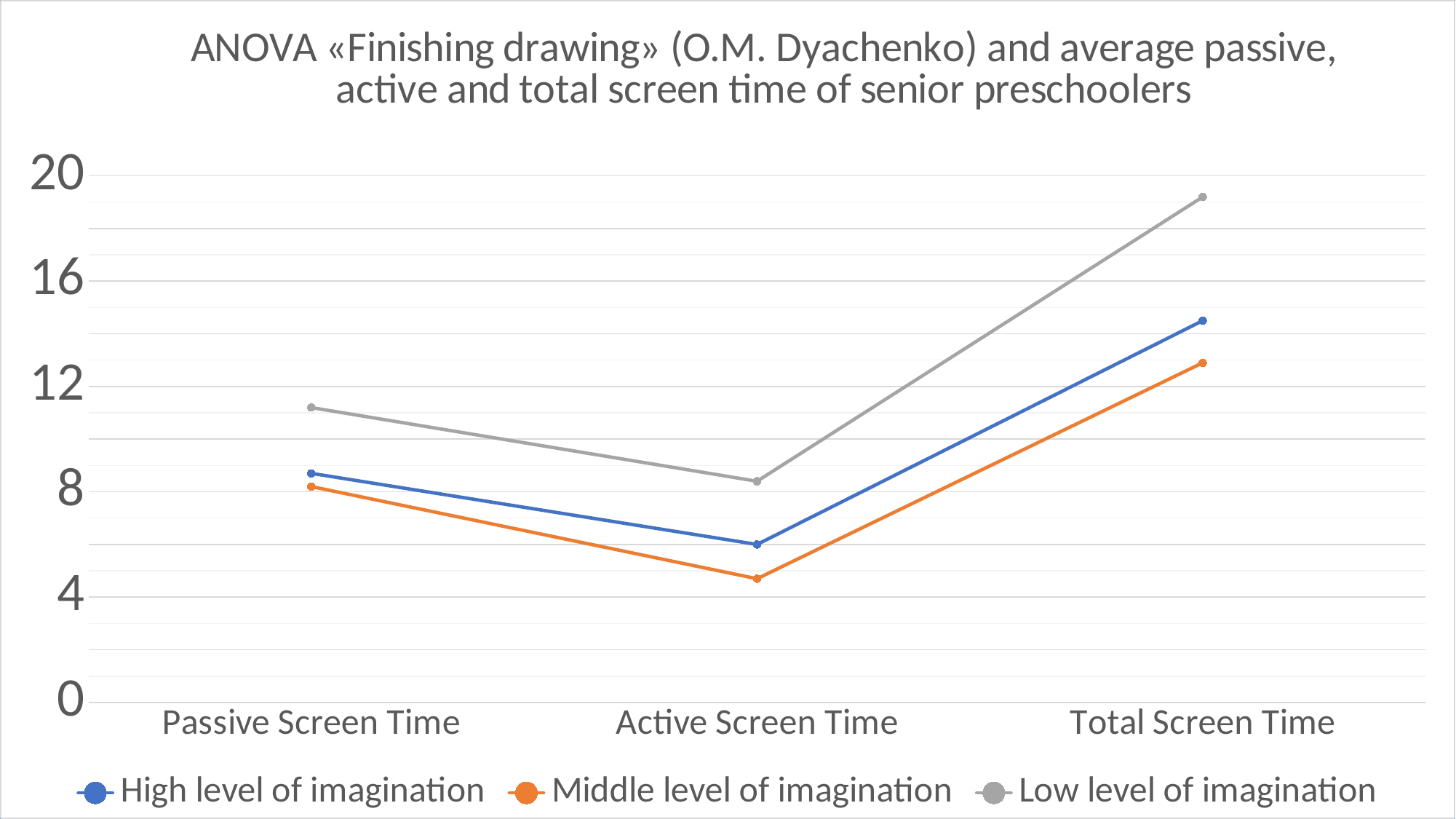
How many categories are shown on the x axis? 3 For the Low level of imagination series, which category has the lowest value? Active Screen Time Which series has the highest value for Total Screen Time? Low level of imagination Is the value for High level of imagination at Active Screen Time greater or less than 8? less Is the value for Low level of imagination at Passive Screen Time greater or less than 8? greater How many series does the legend list? 3 Which is larger at Active Screen Time: High level of imagination or Middle level of imagination? High level of imagination What kind of chart is shown on the slide? line chart Which series has the lowest value for Active Screen Time? Middle level of imagination Does the Low level of imagination series rise or fall from Passive Screen Time to Active Screen Time? fall Which colour represents the Middle level of imagination series? orange Is the value for Low level of imagination at Total Screen Time greater or less than 16? greater